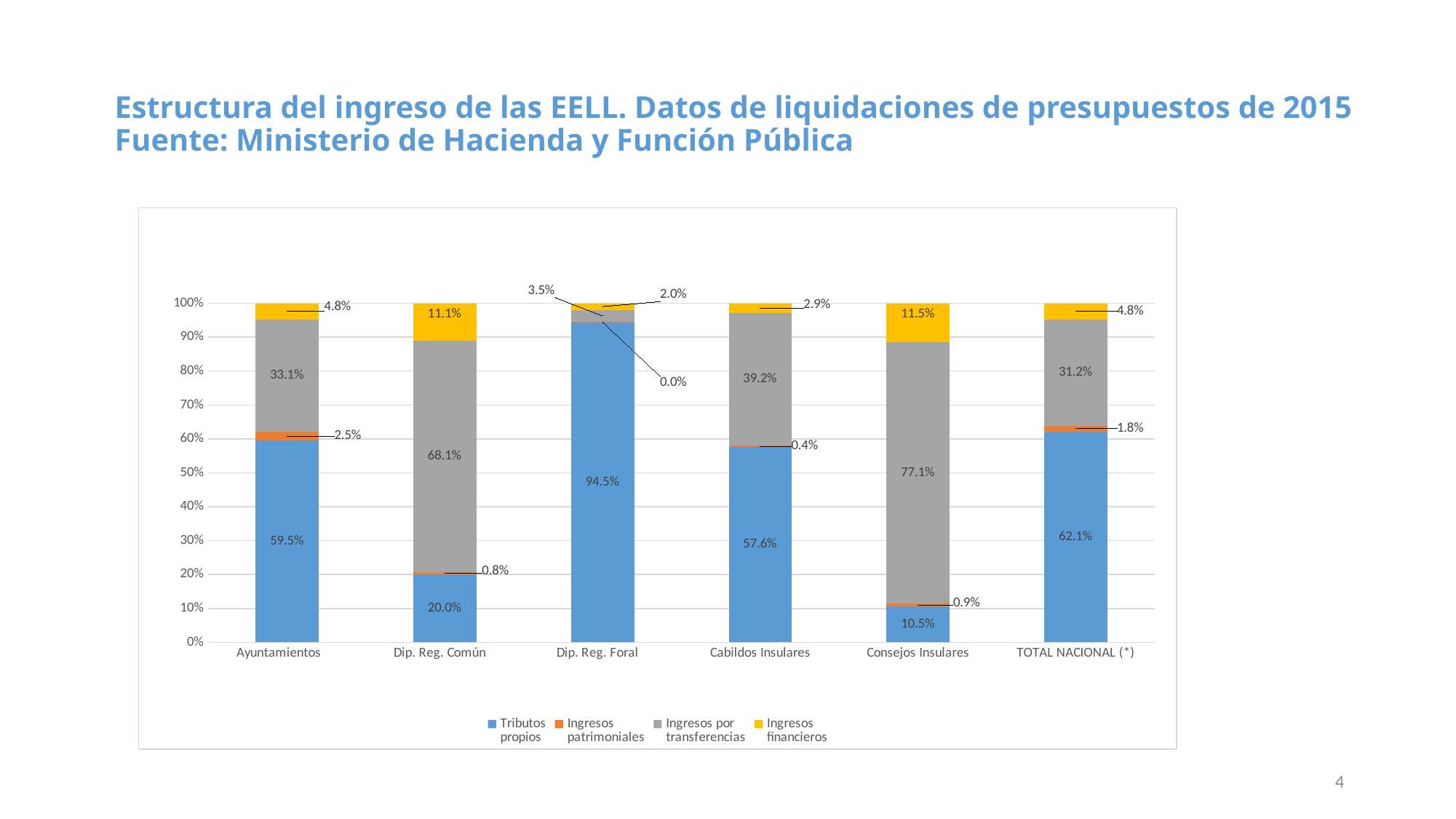
What kind of chart is shown on the slide? Stacked bar chart Which is larger: Ingresos por transferencias for Cabildos Insulares or for Ayuntamientos? Cabildos Insulares What is the value of Tributos propios for Ayuntamientos? 59.5% What is the difference between the Tributos propios values for TOTAL NACIONAL (*) and Cabildos Insulares? 4.5% What is the value of Ingresos patrimoniales for TOTAL NACIONAL (*)? 1.8% How many categories are shown on the x axis of the chart? 6 How many series does the legend list? 4 What is the value of Ingresos financieros for Dip. Reg. Común? 11.1% Which series is shown in yellow in the legend? Ingresos financieros Which category has the lowest value for Tributos propios? Consejos Insulares Which category has the highest value for Tributos propios? Dip. Reg. Foral What is the value of Ingresos por transferencias for Consejos Insulares? 77.1%